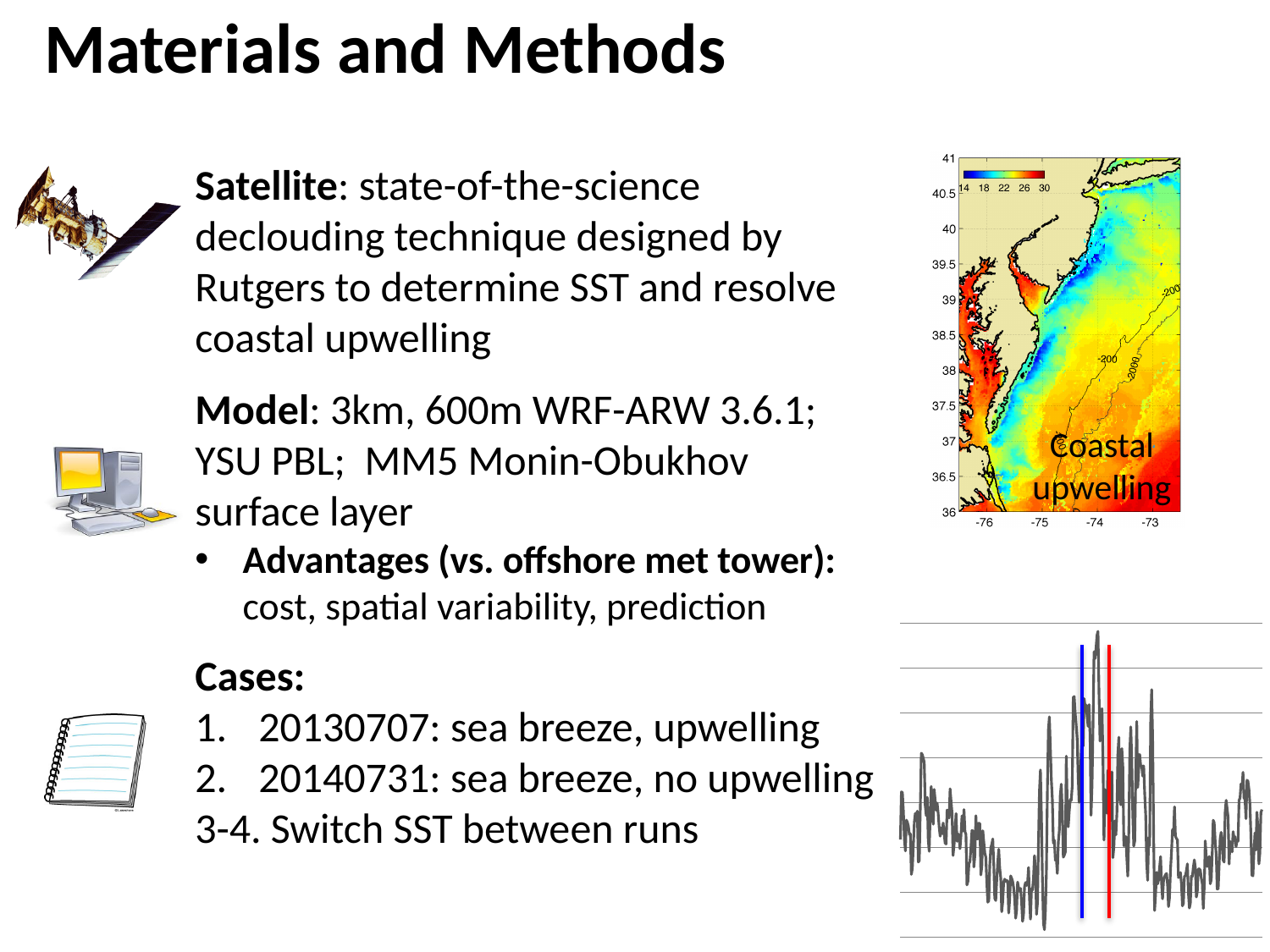
On the map at the top right, how many longitude ticks are labelled on the horizontal axis? 4 What kind of chart is shown at the bottom right of the slide? line chart On the map at the top right, what is the lowest value shown on the colour bar? 14 On the map at the top right, what is the highest latitude tick on the vertical axis? 41 On the map at the top right, what is the lowest latitude tick on the vertical axis? 36 On the bottom-right line chart, what colour is the leftmost vertical marker line? blue On the map at the top right, what is the highest value shown on the colour bar? 30 On the bottom-right line chart, is the blue vertical line to the left or to the right of the red vertical line? left On the bottom-right line chart, how many vertical marker lines are drawn over the data line? 2 On the bottom-right line chart, what colour is the plotted data line? grey